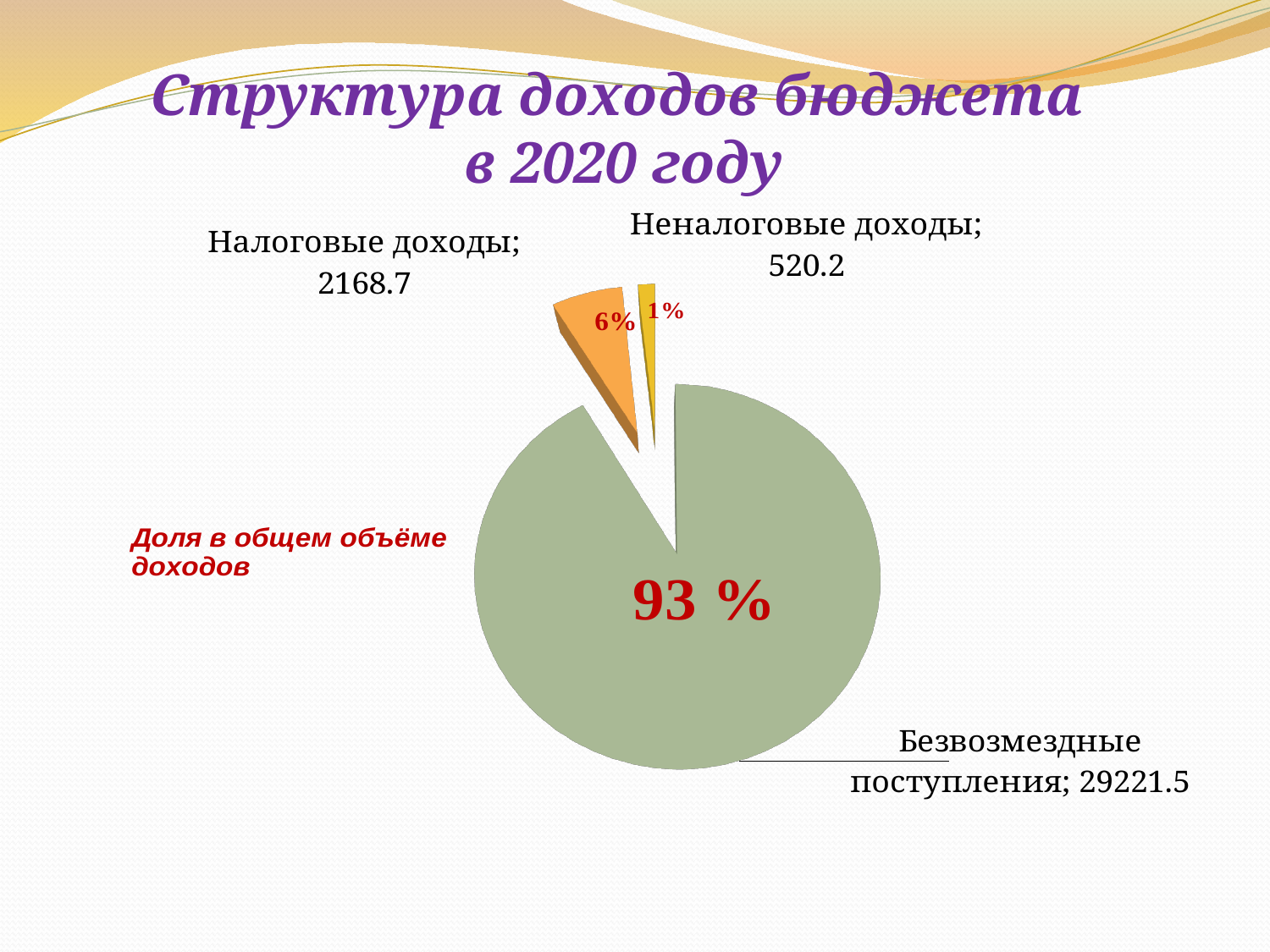
What is the value for Безвозмездные поступления? 29221.5 What share of the pie does Безвозмездные поступления represent? 93 % What is the difference between the values for Налоговые доходы and Неналоговые доходы? 1648.5 Which is larger, the value for Налоговые доходы or the value for Неналоговые доходы? Налоговые доходы What is the value for Налоговые доходы? 2168.7 Which category has the smallest slice of the pie? Неналоговые доходы What kind of chart is shown on the slide? Pie chart What share of the pie does Налоговые доходы represent? 6% Which category has the largest slice of the pie? Безвозмездные поступления What is the difference between the values for Безвозмездные поступления and Налоговые доходы? 27052.8 What is the value for Неналоговые доходы? 520.2 How many categories does the pie chart show? 3